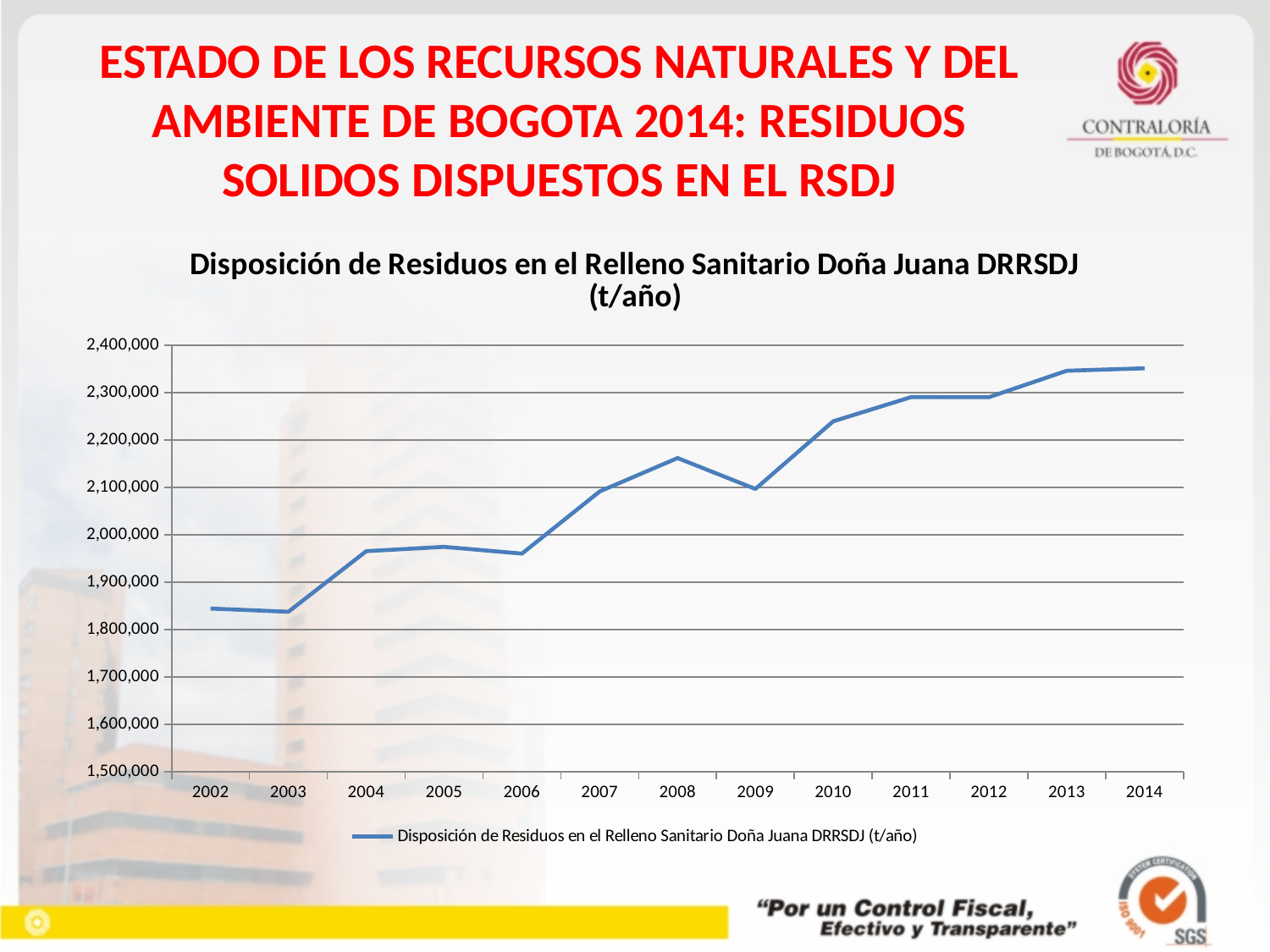
How many series does the legend list? 1 Which year has the larger value, 2006 or 2010? 2010 How many years are plotted on the x axis of the chart? 13 What kind of chart is shown on the slide? line chart Which year has the larger value, 2008 or 2009? 2008 Is the value for 2010 greater or less than 2,200,000? greater Is the value for 2002 greater or less than 1,900,000? less Is the value for 2008 greater or less than 2,100,000? greater What is the title of the chart? Disposición de Residuos en el Relleno Sanitario Doña Juana DRRSDJ (t/año) Overall, do the values rise or fall from 2002 to 2014? rise